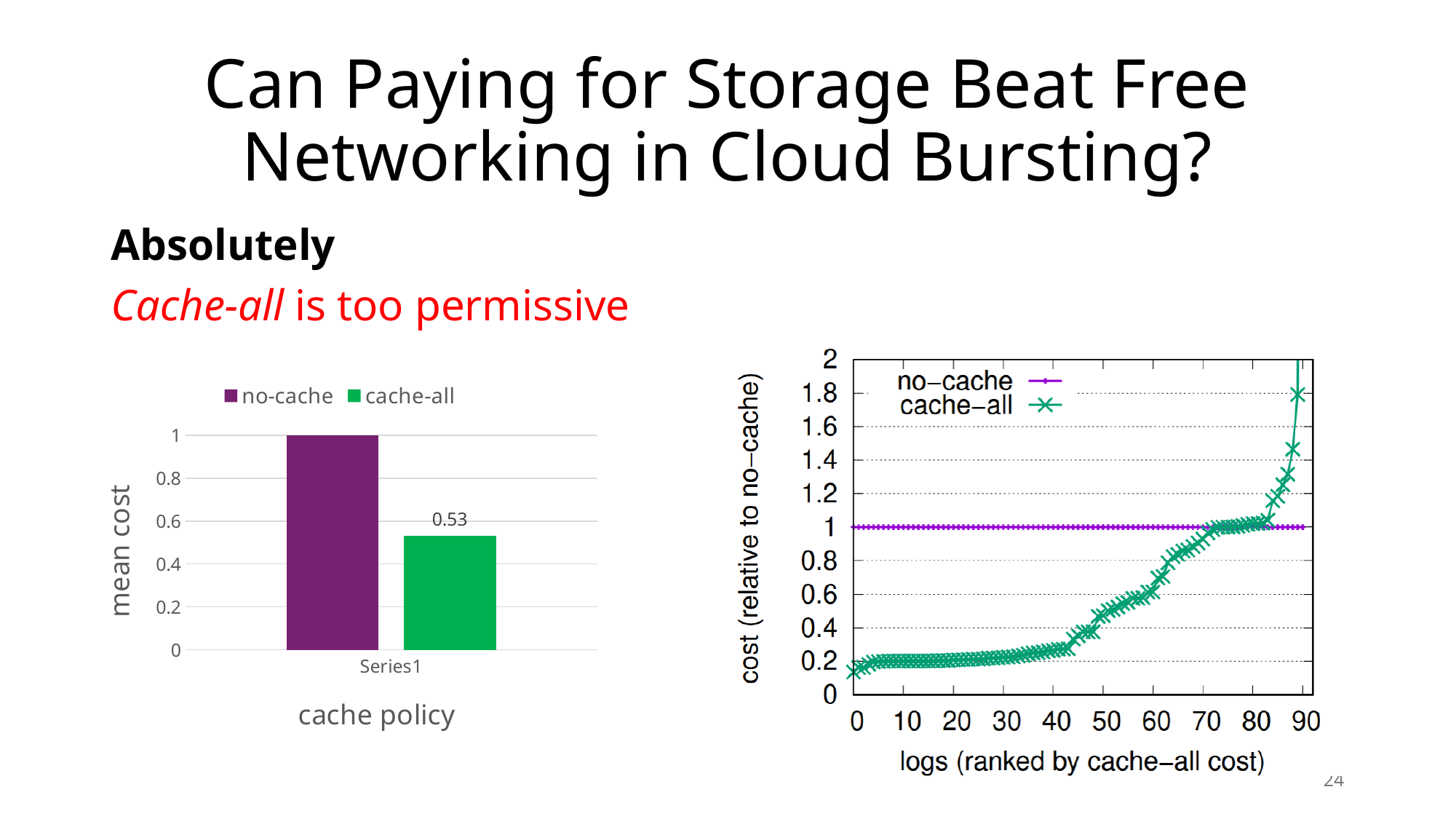
How many series does the legend of the left bar chart list? 2 In the right chart, is the cache-all cost at log rank 0 greater or less than 0.2? less In the left bar chart, what is the mean cost for no-cache? 1 How many series does the legend of the right chart list? 2 In the right chart, does the cache-all line rise or fall as the log rank increases along the x axis? rises In the left bar chart, which cache policy has the higher mean cost? no-cache What is the y-axis title of the left bar chart? mean cost What kind of chart is the left chart (mean cost vs cache policy)? bar chart In the left bar chart, what is the difference in mean cost between no-cache and cache-all? 0.47 What is the x-axis title of the right chart? logs (ranked by cache-all cost) In the left bar chart, what is the mean cost for cache-all? 0.53 What kind of chart is the right chart (cost relative to no-cache)? line chart